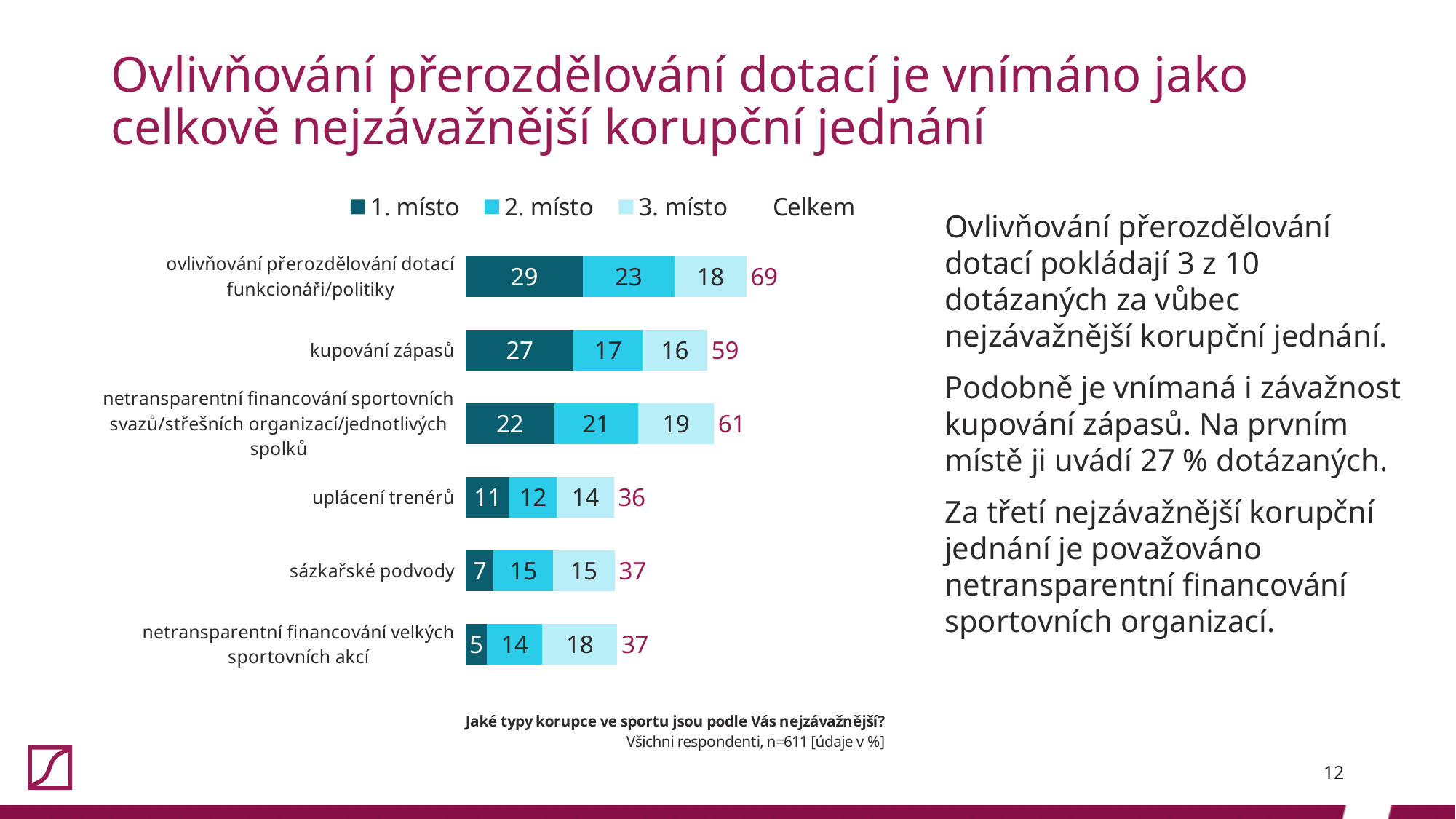
What is the difference between the '1. místo' values for 'kupování zápasů' and 'sázkařské podvody'? 20 What is the '1. místo' value for 'ovlivňování přerozdělování dotací funkcionáři/politiky'? 29 Which is larger: the '2. místo' value for 'sázkařské podvody' or the '2. místo' value for 'uplácení trenérů'? sázkařské podvody What is the '2. místo' value for 'kupování zápasů'? 17 Which category has the highest '1. místo' value? ovlivňování přerozdělování dotací funkcionáři/politiky What type of chart is shown on the slide? stacked bar chart What is the 'Celkem' total shown for 'uplácení trenérů'? 36 What is the 'Celkem' total shown for 'netransparentní financování sportovních svazů/střešních organizací/jednotlivých spolků'? 61 What is the '3. místo' value for 'netransparentní financování velkých sportovních akcí'? 18 Which category has the lowest '1. místo' value? netransparentní financování velkých sportovních akcí How many entries does the chart legend list? 4 How many categories are shown in the chart? 6